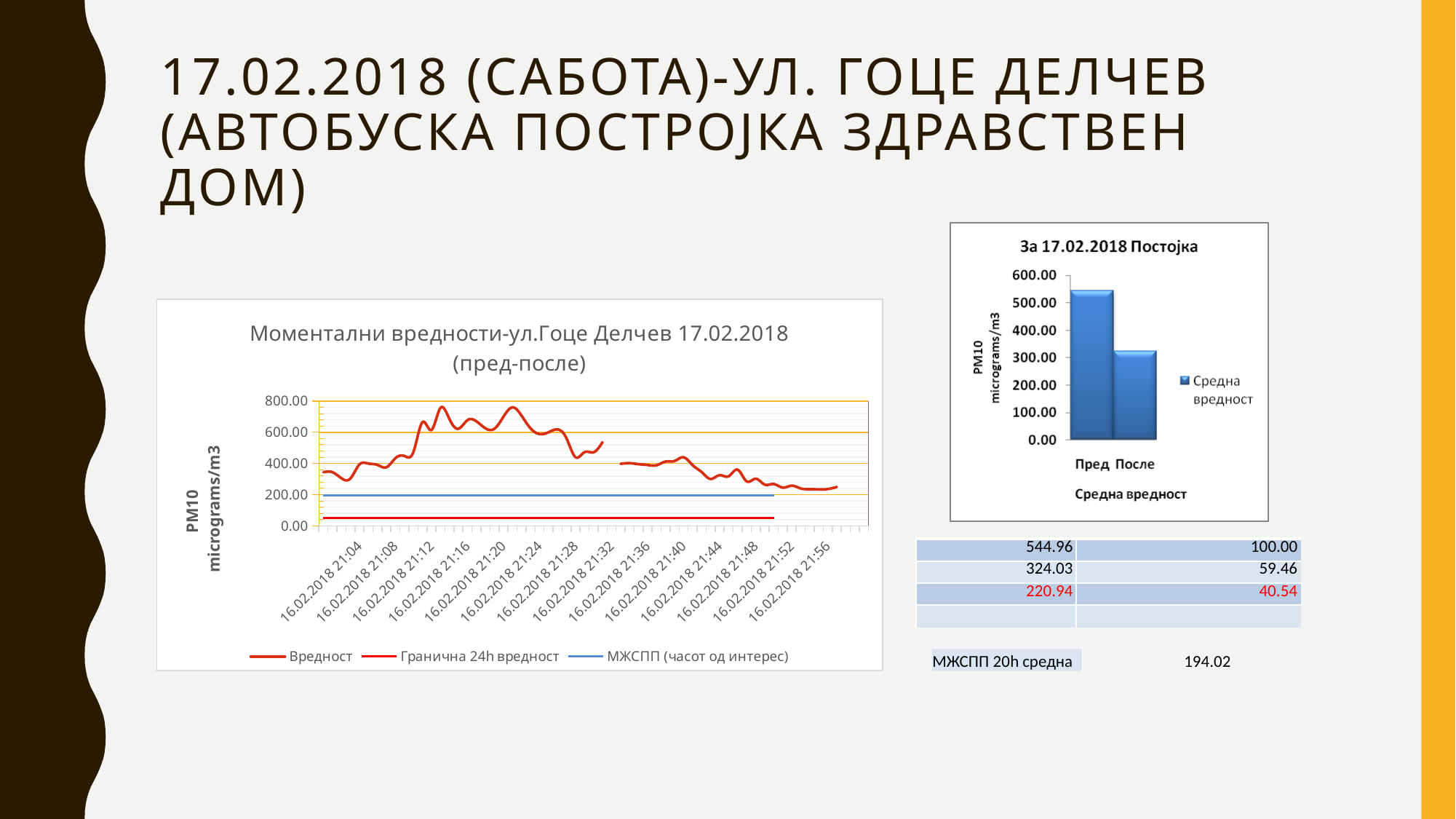
In the chart "За 17.02.2018 Постојка", what is the legend entry? Средна вредност In the chart "За 17.02.2018 Постојка", is the value for После greater or less than 400.00? less In the chart "Моментални вредности-ул.Гоце Делчев 17.02.2018 (пред-после)", does the Вредност line rise or fall from 16.02.2018 21:36 to 16.02.2018 21:56? fall In the chart "За 17.02.2018 Постојка", is the value for Пред greater or less than 500.00? greater In the chart "За 17.02.2018 Постојка", which category has the highest value? Пред In the chart "За 17.02.2018 Постојка", how many bars are plotted? 2 In the chart "Моментални вредности-ул.Гоце Делчев 17.02.2018 (пред-после)", is the Гранична 24h вредност line greater or less than 200.00? less In the chart "За 17.02.2018 Постојка", which is larger, Пред or После? Пред What kind of chart is the chart titled "За 17.02.2018 Постојка"? bar chart In the chart "За 17.02.2018 Постојка", how many series does the legend list? 1 In the chart "Моментални вредности-ул.Гоце Делчев 17.02.2018 (пред-после)", how many series does the legend list? 3 What kind of chart is the chart titled "Моментални вредности-ул.Гоце Делчев 17.02.2018 (пред-после)"? line chart